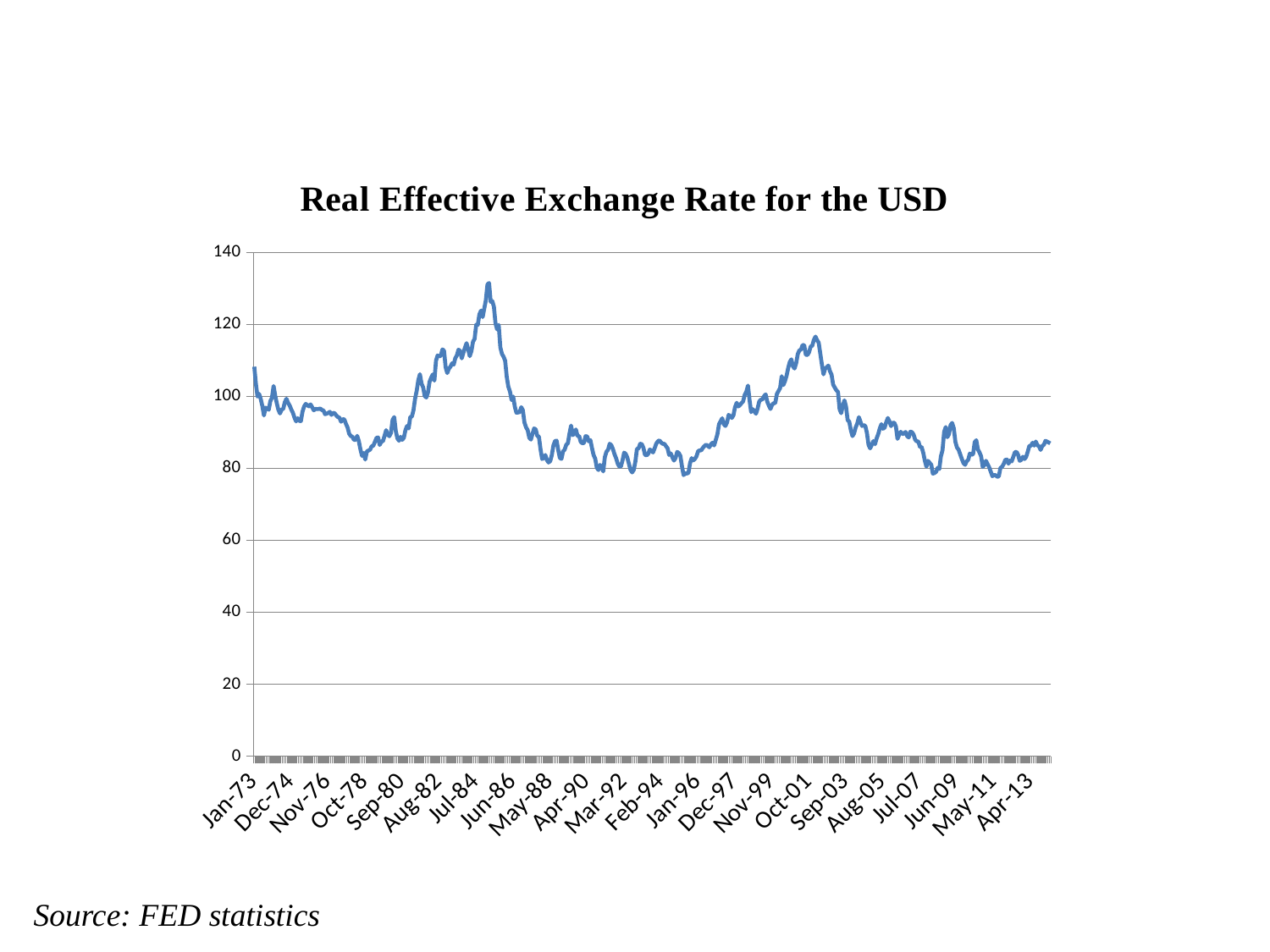
Is the value at Jan-73 greater or less than 100? greater Is the value at Oct-01 greater or less than 100? greater Which peak is higher, the one in the mid-1980s or the one around 2001? the mid-1980s peak Is the value at Oct-78 greater or less than 100? less Does the line rise or fall between Jun-86 and May-88? falls What is the title of the chart? Real Effective Exchange Rate for the USD What kind of chart is shown on the slide? line chart What source is cited for the chart data? FED statistics Does the line rise or fall between Oct-78 and Jul-84? rises